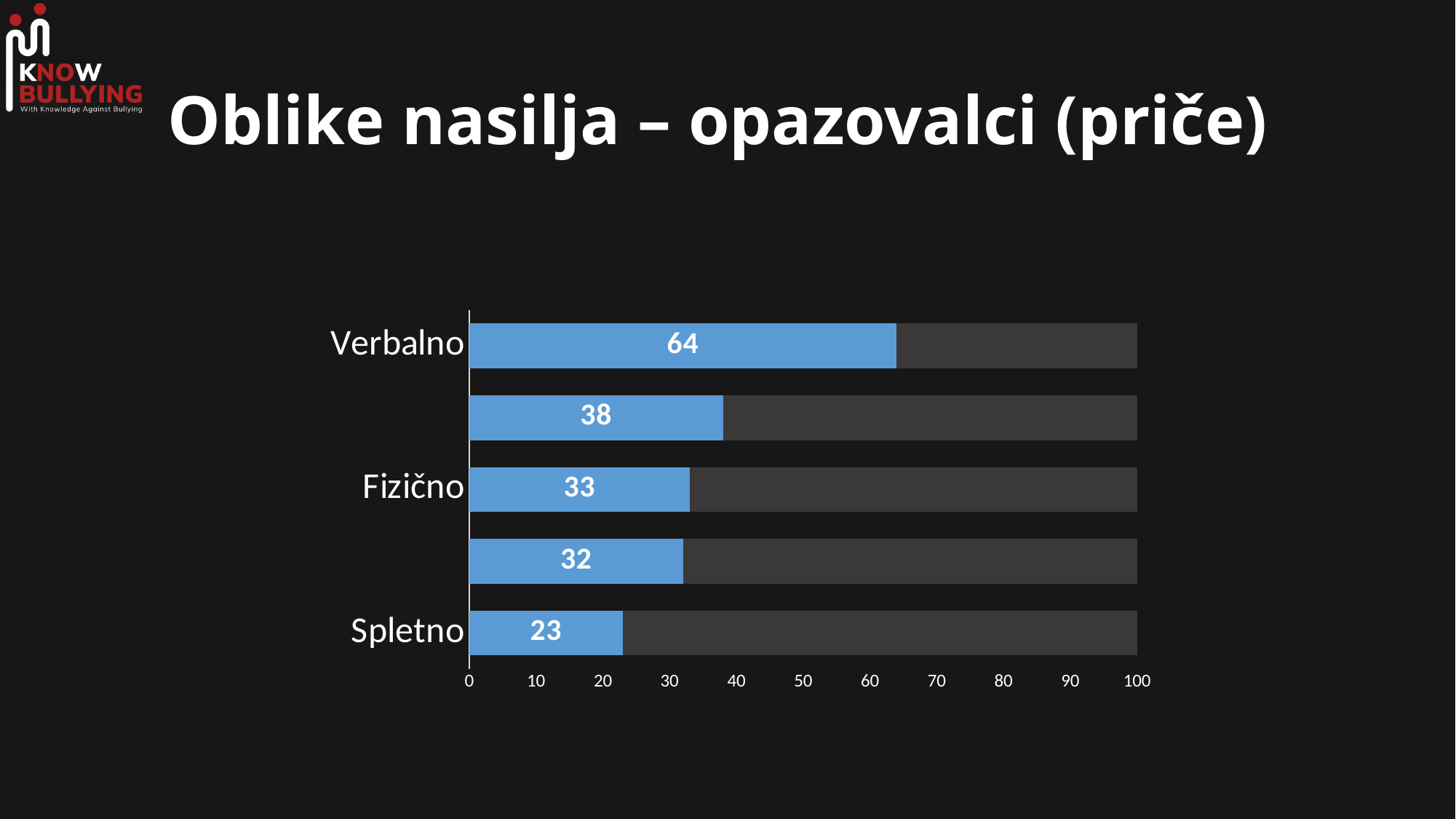
Which category has the highest value? Verbalno What is the value for Spletno? 23 What is the value for Fizično? 33 Is the value for Verbalno greater or less than 50? greater What is the maximum value shown on the horizontal axis? 100 Which is larger, the value for Fizično or the value for Spletno? Fizično What is the value for Verbalno? 64 What is the difference between the values for Fizično and Spletno? 10 How many bars are plotted in the chart? 5 Which category has the lowest value? Spletno What is the difference between the values for Verbalno and Spletno? 41 What kind of chart is shown on the slide? Bar chart